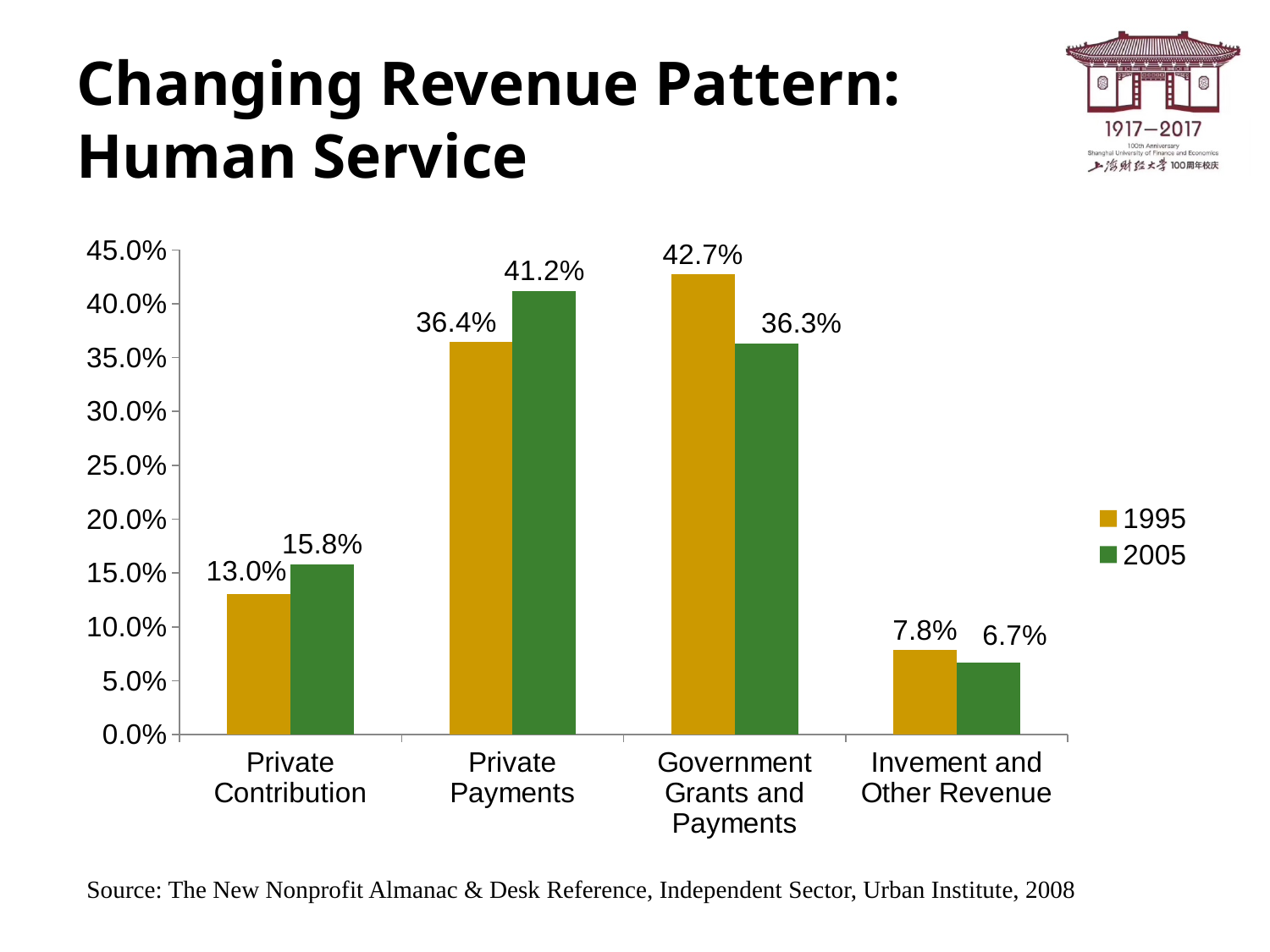
Which series is shown in green in the legend? 2005 What is the difference between the 1995 and 2005 values for Government Grants and Payments? 6.4% How many categories are shown on the x axis? 4 What is the 2005 value for Private Payments? 41.2% What is the 2005 value for Government Grants and Payments? 36.3% What is the 1995 value for Private Contribution? 13.0% What kind of chart is shown on the slide? Bar chart Which category has the highest 1995 value? Government Grants and Payments Which is larger for Private Payments, the 1995 value or the 2005 value? 2005 Which category has the lowest 2005 value? Invement and Other Revenue What is the 1995 value for Invement and Other Revenue? 7.8% How many series does the legend list? 2